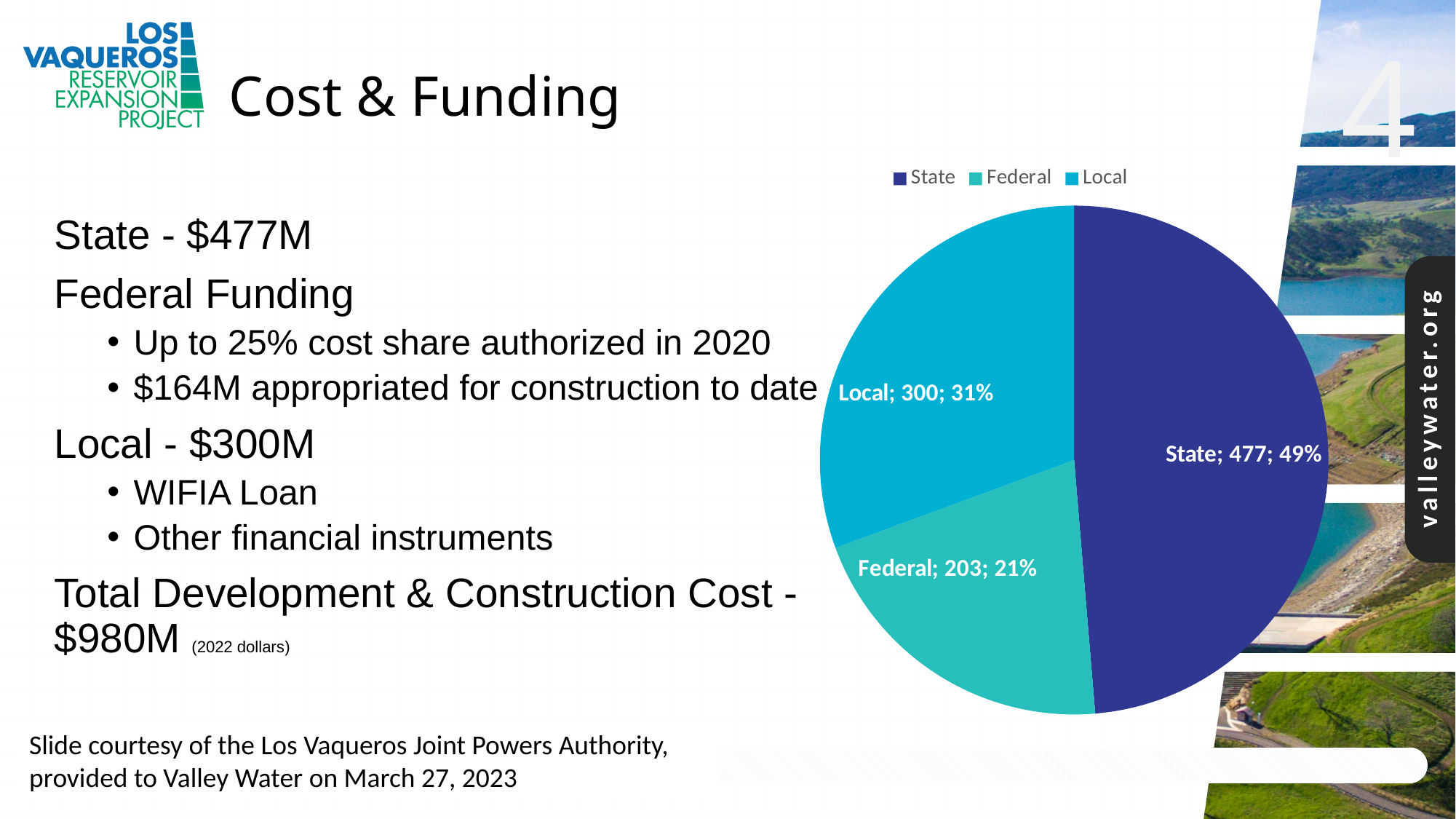
What is the value for Federal in the pie chart? 203 What share of the pie does Federal represent? 21% What is the value for Local in the pie chart? 300 What kind of chart is shown on the slide? pie chart What is the difference between the State value and the Local value? 177 Which category has the smallest slice in the pie chart? Federal What is the value for State in the pie chart? 477 How many entries does the legend list? 3 What share of the pie does Local represent? 31% How many slices does the pie chart have? 3 Which category has the largest slice in the pie chart? State Which is larger, the Local value or the Federal value? Local